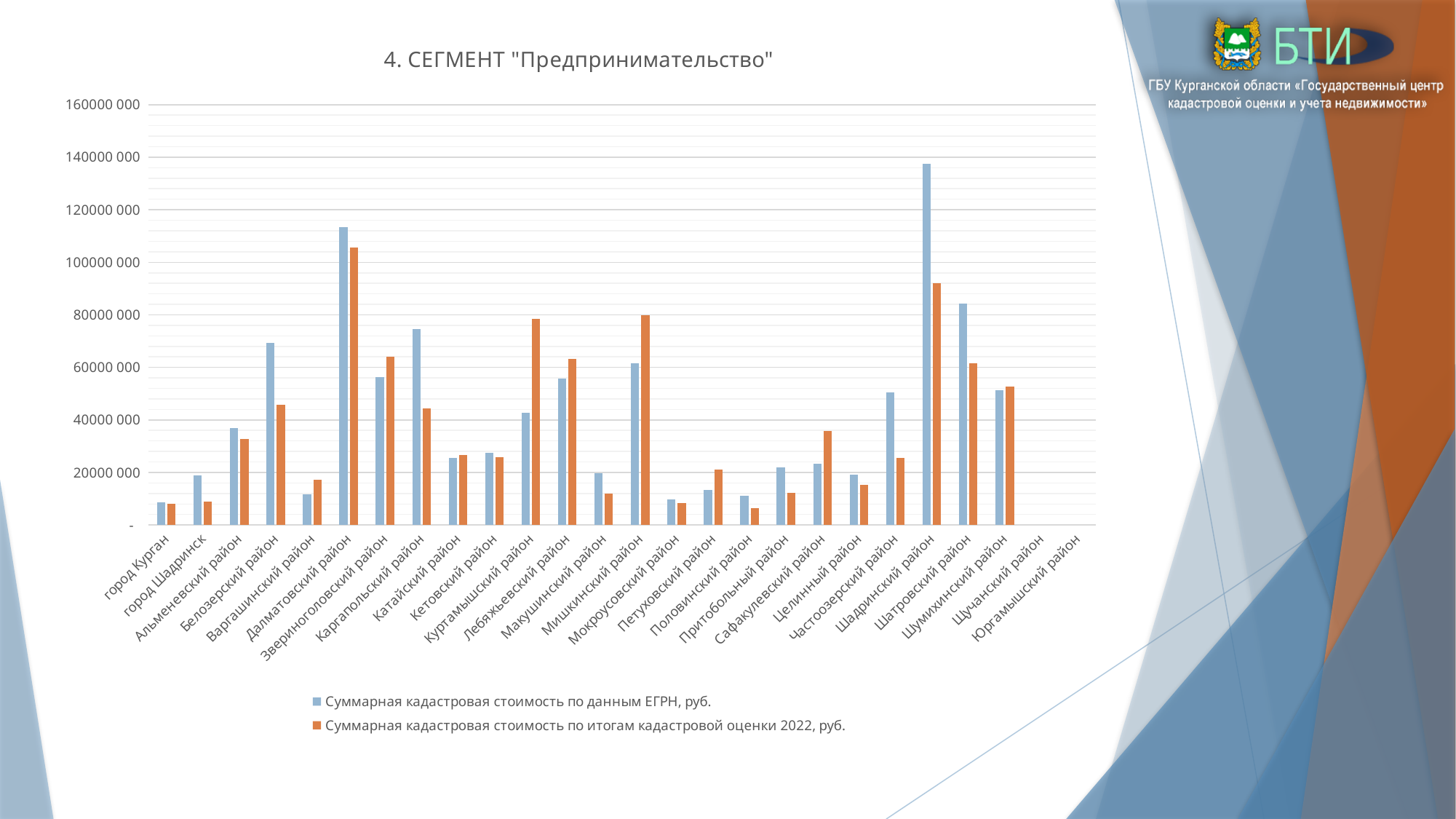
Is the value for город Курган in the series "Суммарная кадастровая стоимость по данным ЕГРН, руб." greater or less than 20000 000? less Is the value for Далматовский район in the series "Суммарная кадастровая стоимость по данным ЕГРН, руб." greater or less than 100000 000? greater What is the title of the chart? 4. СЕГМЕНТ "Предпринимательство" For Белозерский район, which series has the larger value: "Суммарная кадастровая стоимость по данным ЕГРН, руб." or "Суммарная кадастровая стоимость по итогам кадастровой оценки 2022, руб."? Суммарная кадастровая стоимость по данным ЕГРН, руб. For Куртамышский район, which series has the larger value: "Суммарная кадастровая стоимость по данным ЕГРН, руб." or "Суммарная кадастровая стоимость по итогам кадастровой оценки 2022, руб."? Суммарная кадастровая стоимость по итогам кадастровой оценки 2022, руб. Which category has the highest value for the series "Суммарная кадастровая стоимость по итогам кадастровой оценки 2022, руб."? Далматовский район Is the value for Мишкинский район in the series "Суммарная кадастровая стоимость по итогам кадастровой оценки 2022, руб." greater or less than 60000 000? greater Which series is shown in orange? Суммарная кадастровая стоимость по итогам кадастровой оценки 2022, руб. Which category has the highest value for the series "Суммарная кадастровая стоимость по данным ЕГРН, руб."? Шадринский район What kind of chart is shown on the slide? bar chart How many series does the legend list? 2